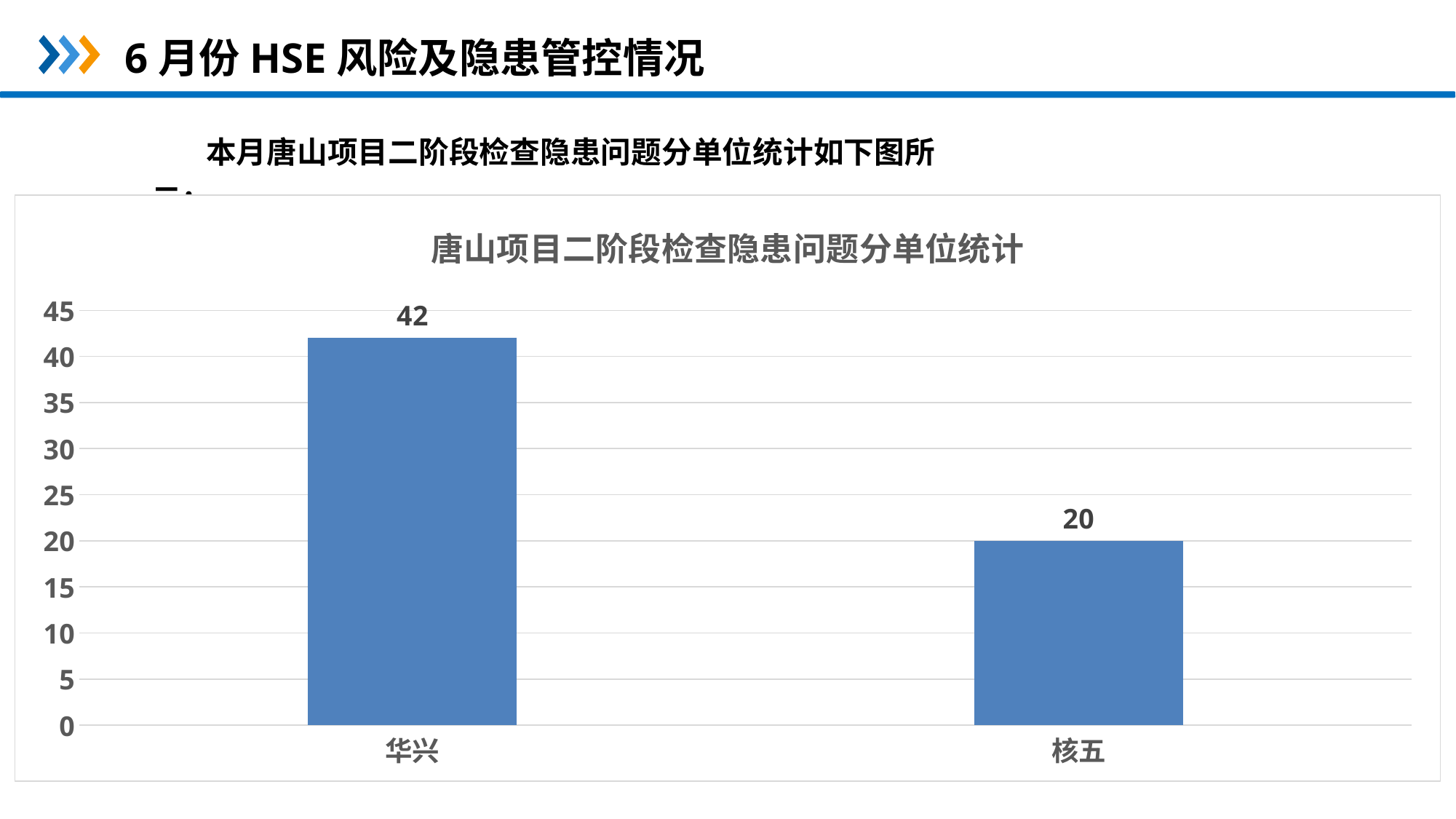
Which is larger, the value for 华兴 or the value for 核五? 华兴 What is the value for 核五? 20 Is the value for 核五 greater or less than 25? less Is the value for 华兴 greater or less than 40? greater What is the value for 华兴? 42 What is the highest value shown on the vertical axis? 45 What kind of chart is shown on the slide? bar chart What is the title of the chart? 唐山项目二阶段检查隐患问题分单位统计 Which category has the highest value? 华兴 Which category has the lowest value? 核五 How many categories are shown on the x axis? 2 What is the difference between the values for 华兴 and 核五? 22